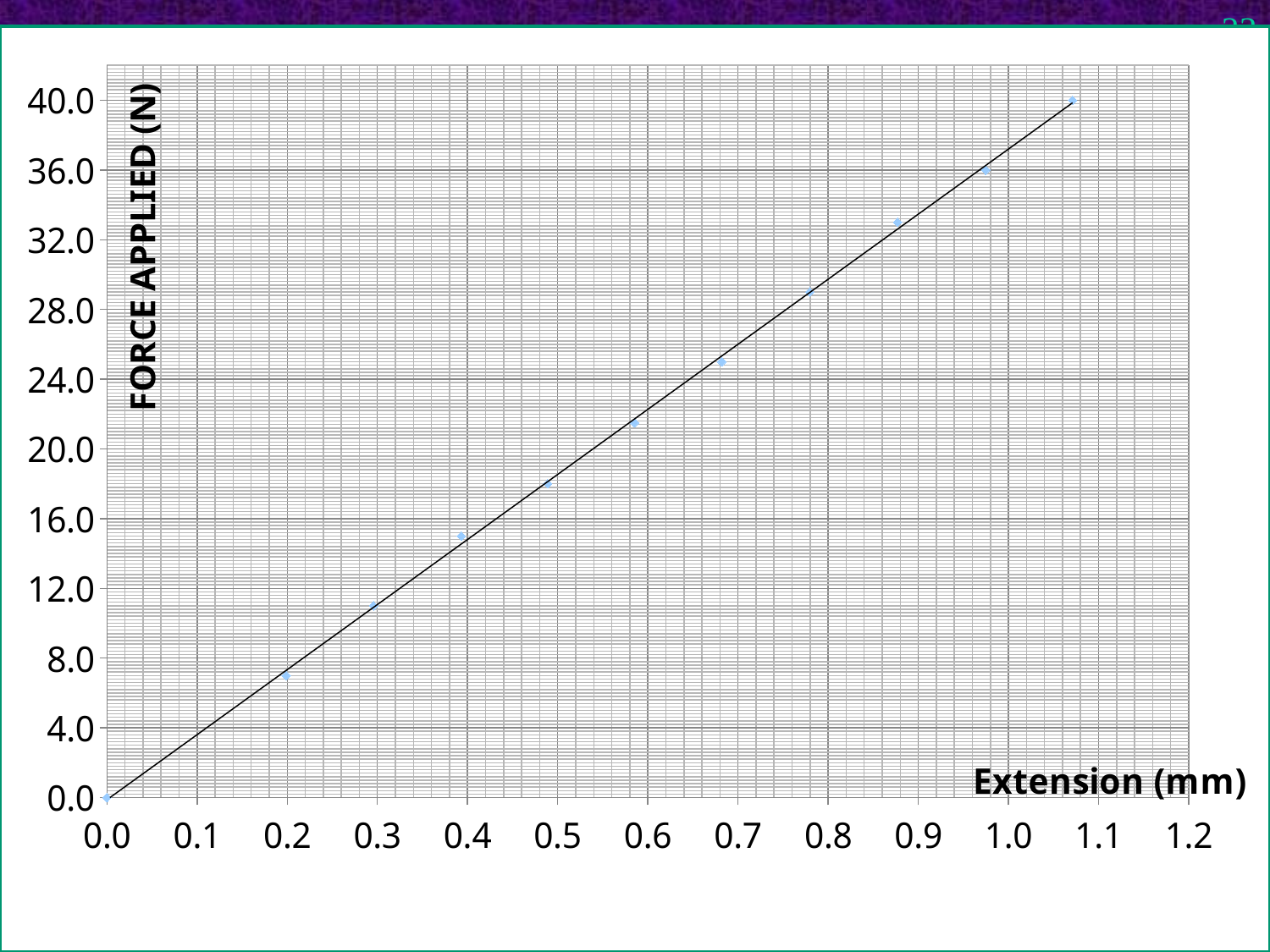
Which plotted point has the highest force applied: the one at 0.4 mm extension or the one at 1.0 mm extension? 1.0 mm Is the force applied at an extension of 0.9 mm greater or less than 36.0 N? less What kind of chart is shown on the slide? scatter chart Is the force applied at an extension of 0.8 mm greater or less than 28.0 N? greater Do the force values rise or fall as extension increases along the x axis? rise Is the force applied at an extension of 1.1 mm greater or less than 36.0 N? greater What is the title of the horizontal axis? Extension (mm) What is the title of the vertical axis? FORCE APPLIED (N)